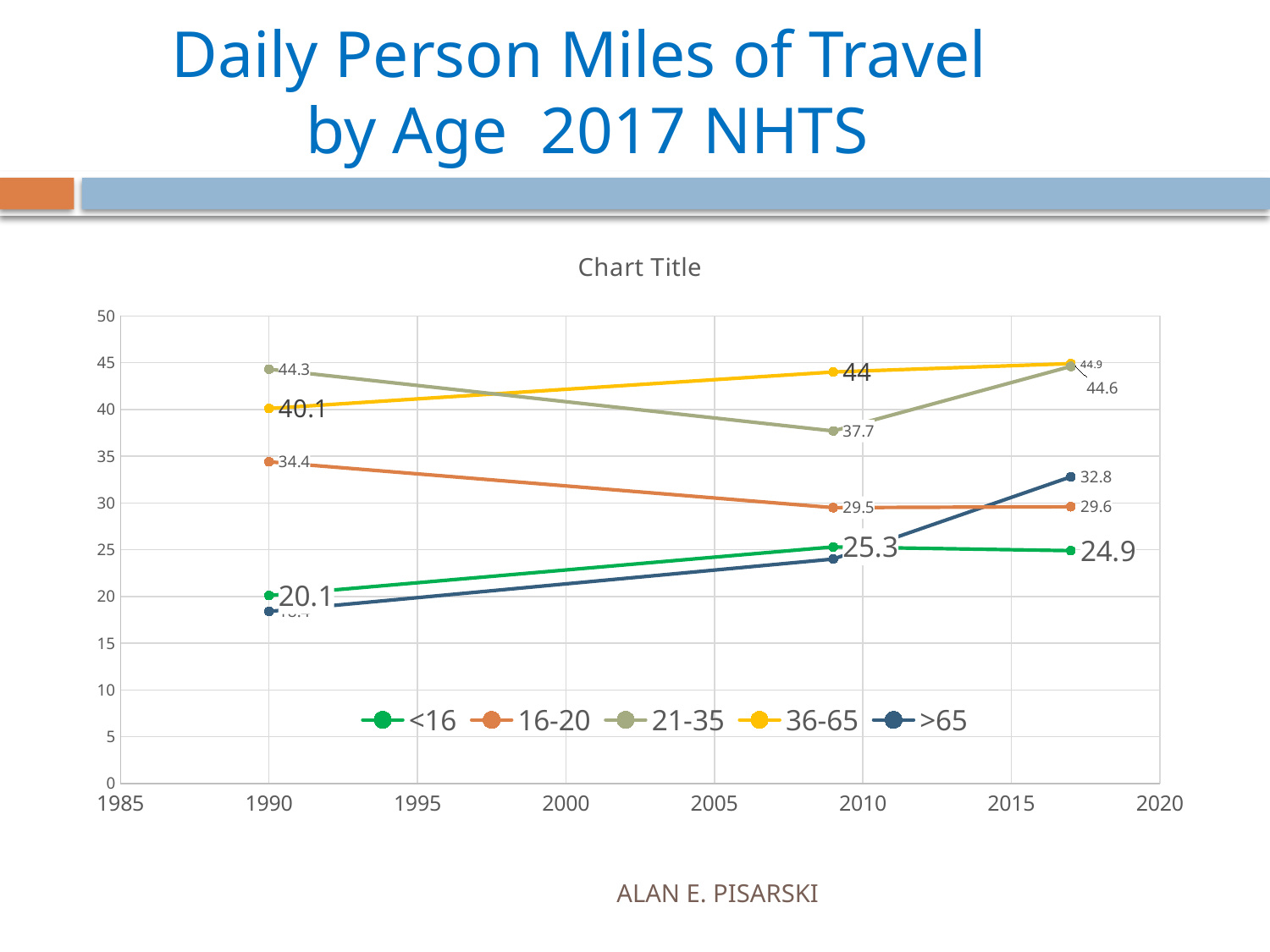
In 2017, which is larger: the value for <16 or the value for >65? >65 What is the value for the >65 age group in 2017? 32.8 How many series does the legend list? 5 What is the value for the 36-65 age group in 2017? 44.9 What is the difference between the <16 values in 2009 and 2017? 0.4 What is the value for the 21-35 age group in 1990? 44.3 Which age group has the lowest value in 2017? <16 What kind of chart is shown on the slide? line chart What is the value for the 16-20 age group in 2009? 29.5 Does the value for the >65 age group rise or fall from 1990 to 2017? rise Is the value for the >65 age group in 2009 greater or less than 30? less By how much did the value for the 21-35 age group fall from 1990 to 2009? 6.6